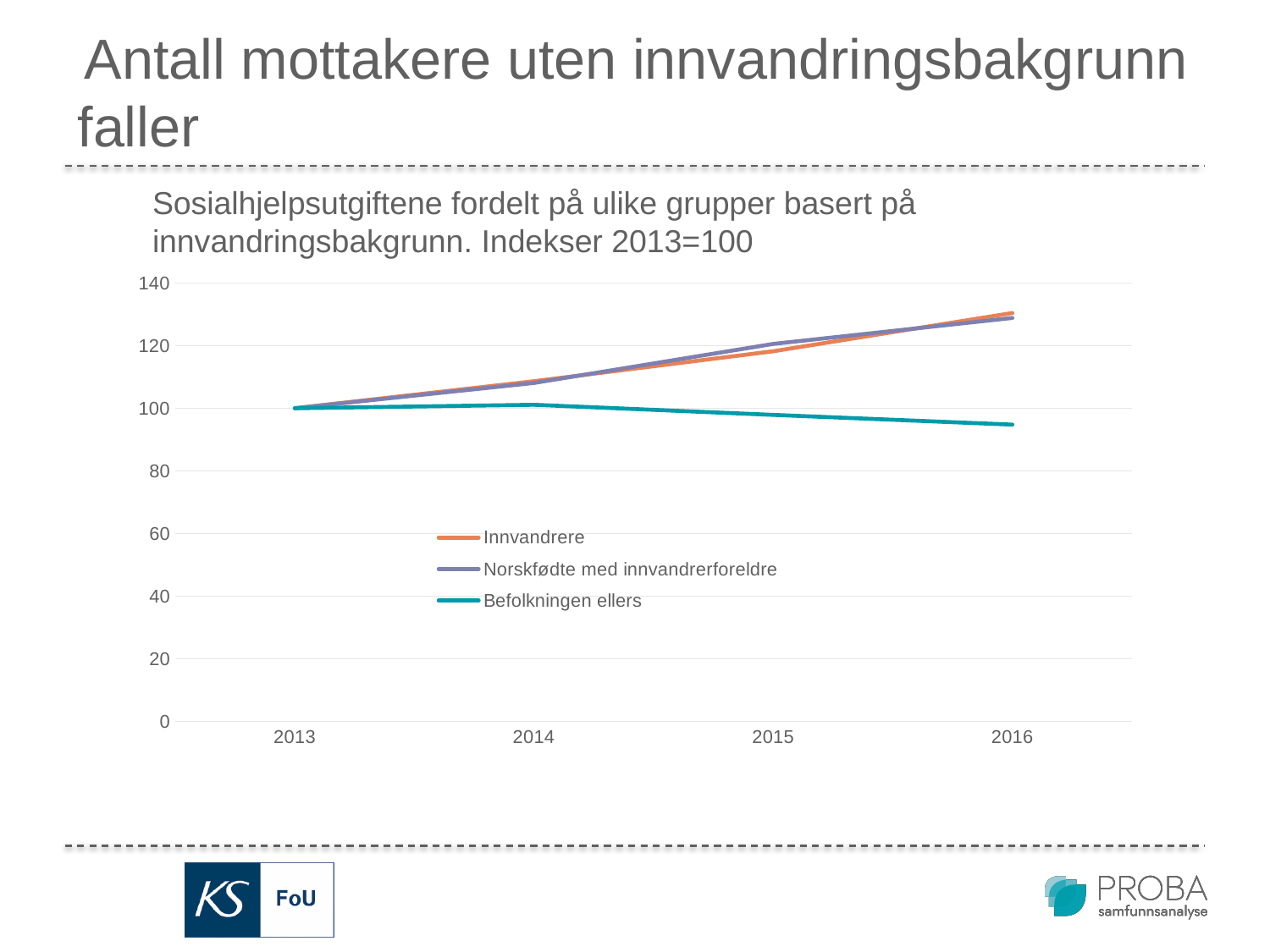
Is the value for Norskfødte med innvandrerforeldre in 2016 greater or less than 120? greater What kind of chart is shown on the slide? Line chart How many years are shown on the x axis? 4 Does the line for Innvandrere rise or fall from 2013 to 2016? Rises What is the index value for Innvandrere in 2013? 100 How many series does the legend list? 3 Is the value for Befolkningen ellers in 2016 greater or less than 100? less Is the value for Innvandrere in 2016 greater or less than 120? greater Which series has the lowest value in 2016? Befolkningen ellers Does the line for Befolkningen ellers rise or fall from 2014 to 2016? Falls In 2016, which is larger: the value for Innvandrere or the value for Befolkningen ellers? Innvandrere What is the index value for Befolkningen ellers in 2013? 100